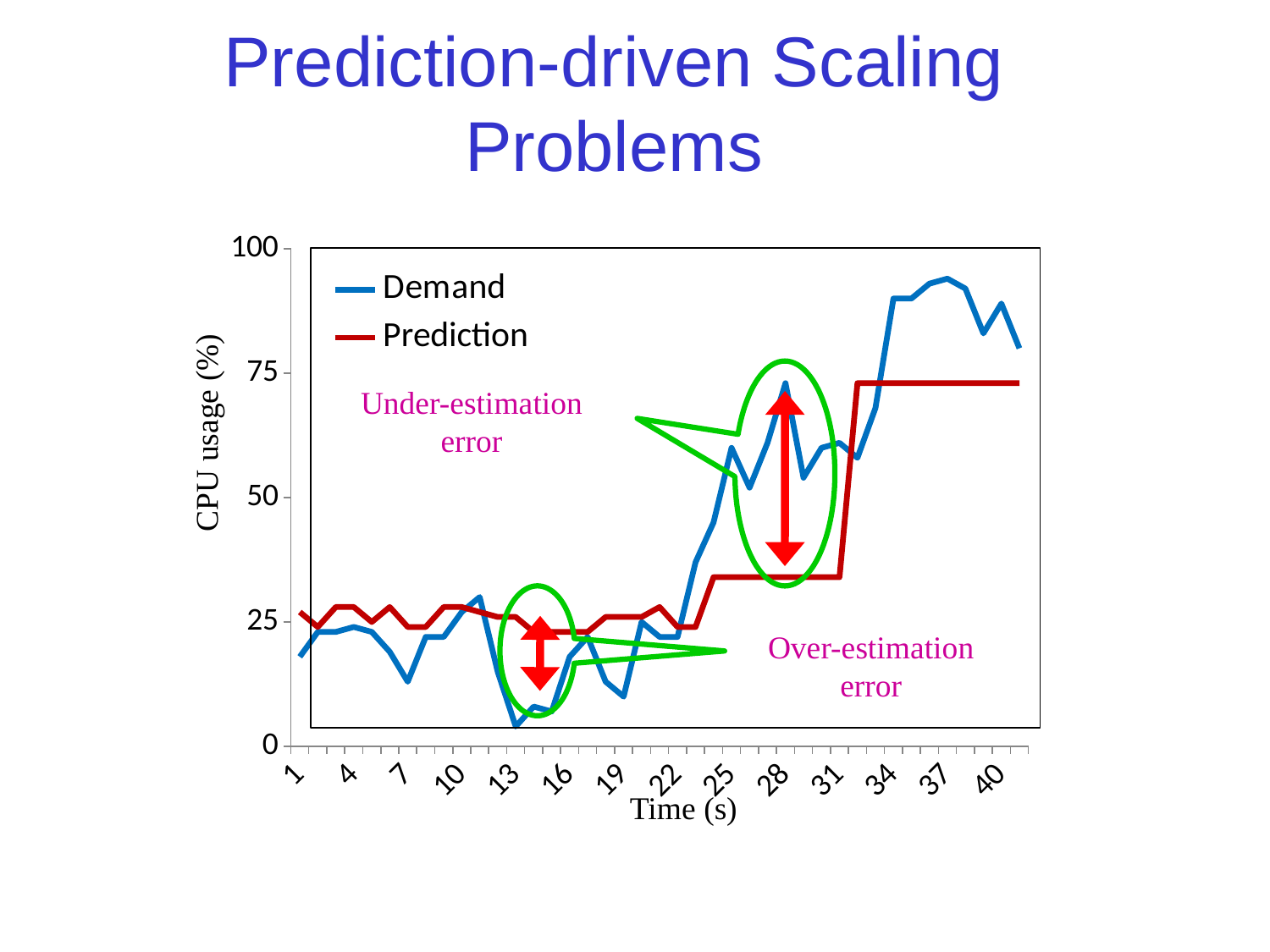
Is the Prediction value at time 28 greater or less than 50? less Is the Prediction value at time 37 greater or less than 50? greater What are the two series named in the legend? Demand and Prediction Does the Prediction series overall rise or fall as time increases from 1 to 40? rise What is the label of the y axis? CPU usage (%) How many series does the legend list? 2 At time 28, which series has the larger value, Demand or Prediction? Demand Is the Demand value at time 37 greater or less than 75? greater What kind of chart is shown on the slide? line chart At time 14, which series has the larger value, Demand or Prediction? Prediction